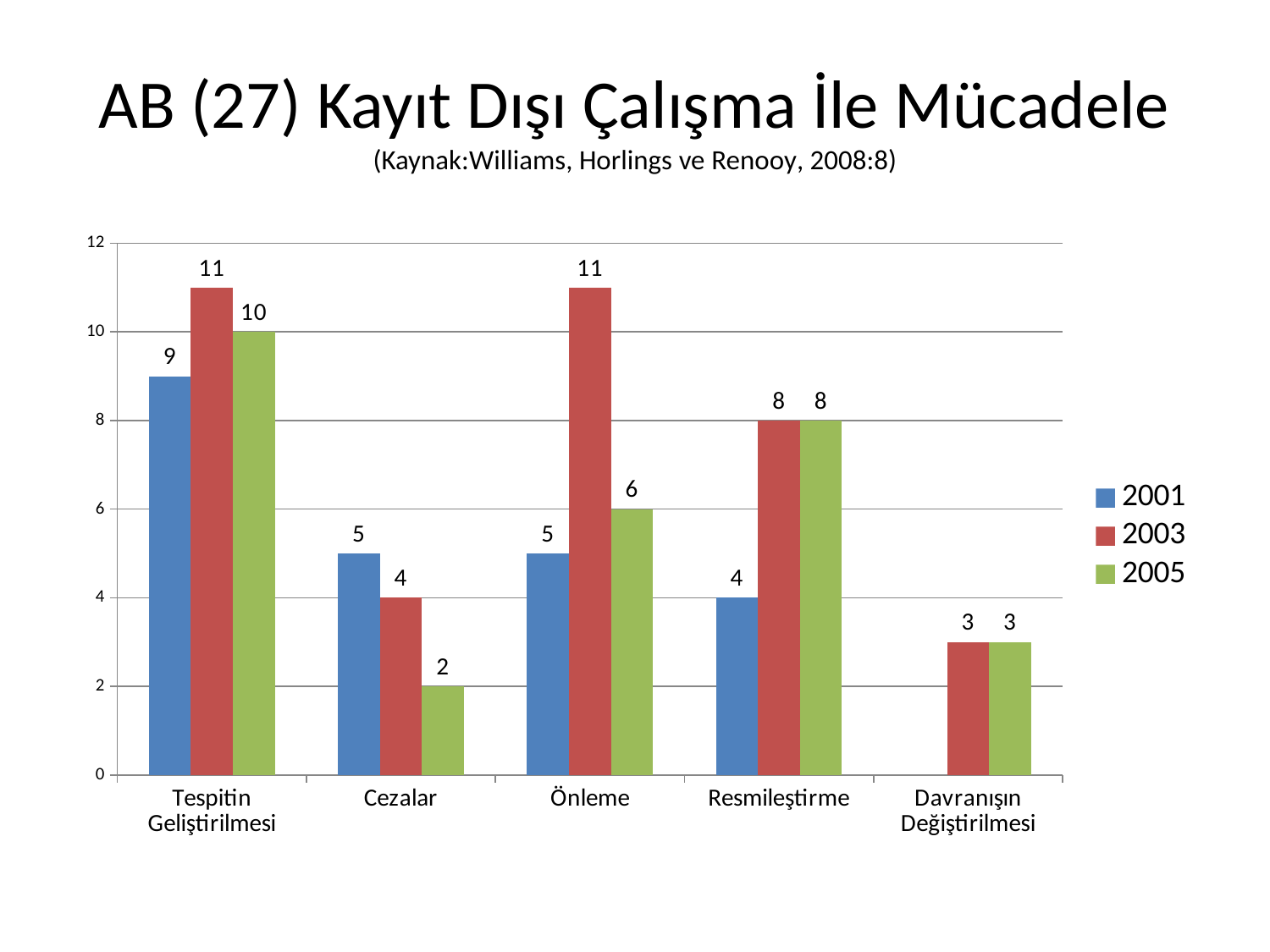
Which category has the lowest value in the 2005 series? Cezalar What is the value for Cezalar in the 2005 series? 2 What is the difference between the 2003 and 2005 values for Önleme? 5 Do the values for Cezalar rise or fall from 2001 to 2005? fall Which series is shown in green in the legend? 2005 What is the value for Resmileştirme in the 2001 series? 4 What is the value for Önleme in the 2003 series? 11 How many series does the legend list? 3 Which category has the highest value in the 2001 series? Tespitin Geliştirilmesi Which is larger for Tespitin Geliştirilmesi: the 2001 value or the 2005 value? 2005 How many categories are shown on the x axis? 5 What kind of chart is shown on the slide? bar chart